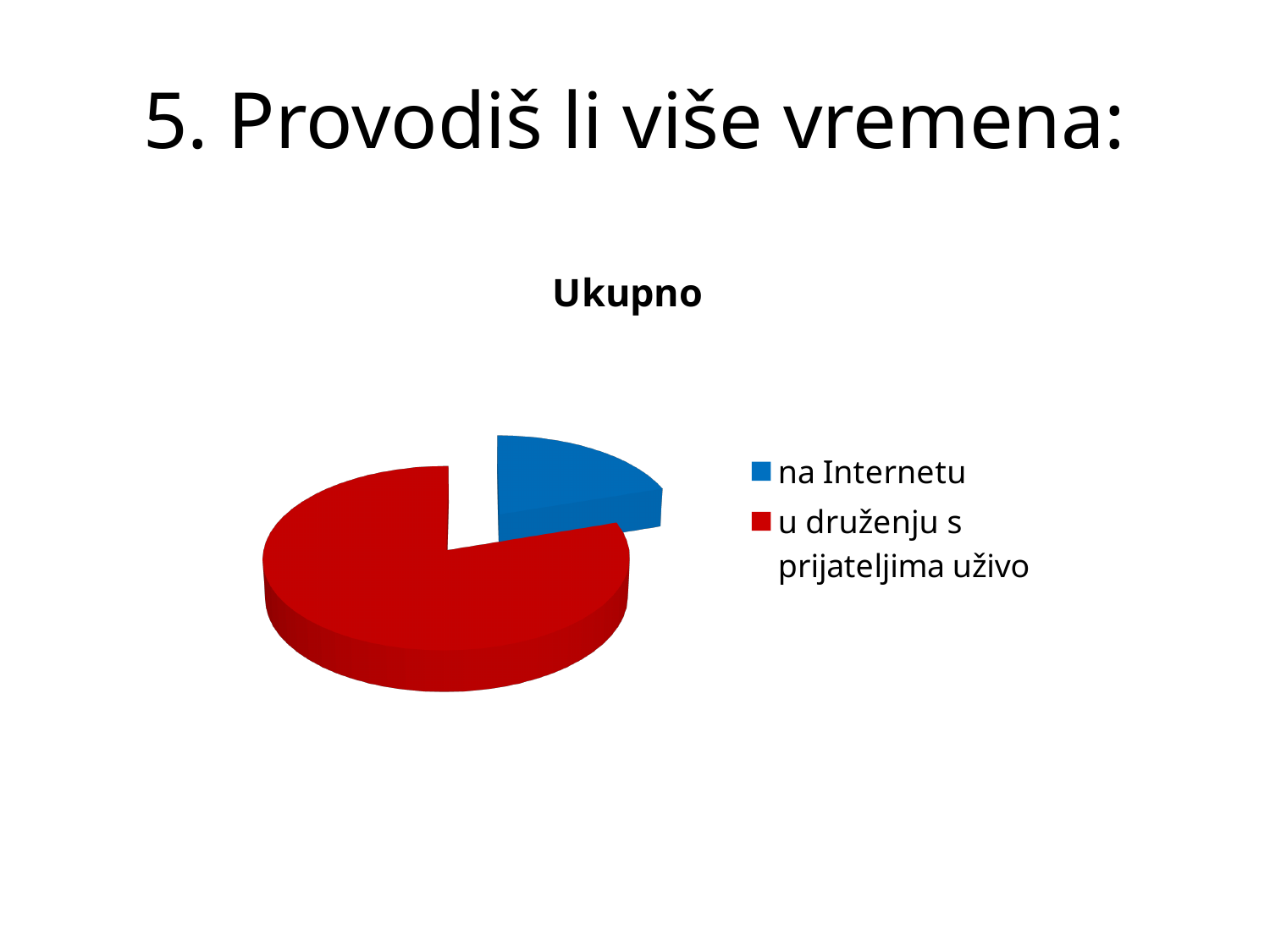
What is the title of the chart? Ukupno What colour is the slice for 'na Internetu'? blue How many categories does the pie chart have? 2 Which slice is larger, 'na Internetu' or 'u druženju s prijateljima uživo'? u druženju s prijateljima uživo Which category has the largest slice of the pie? u druženju s prijateljima uživo Which category has the smallest slice of the pie? na Internetu How many entries does the legend list? 2 What kind of chart is shown on the slide? pie chart